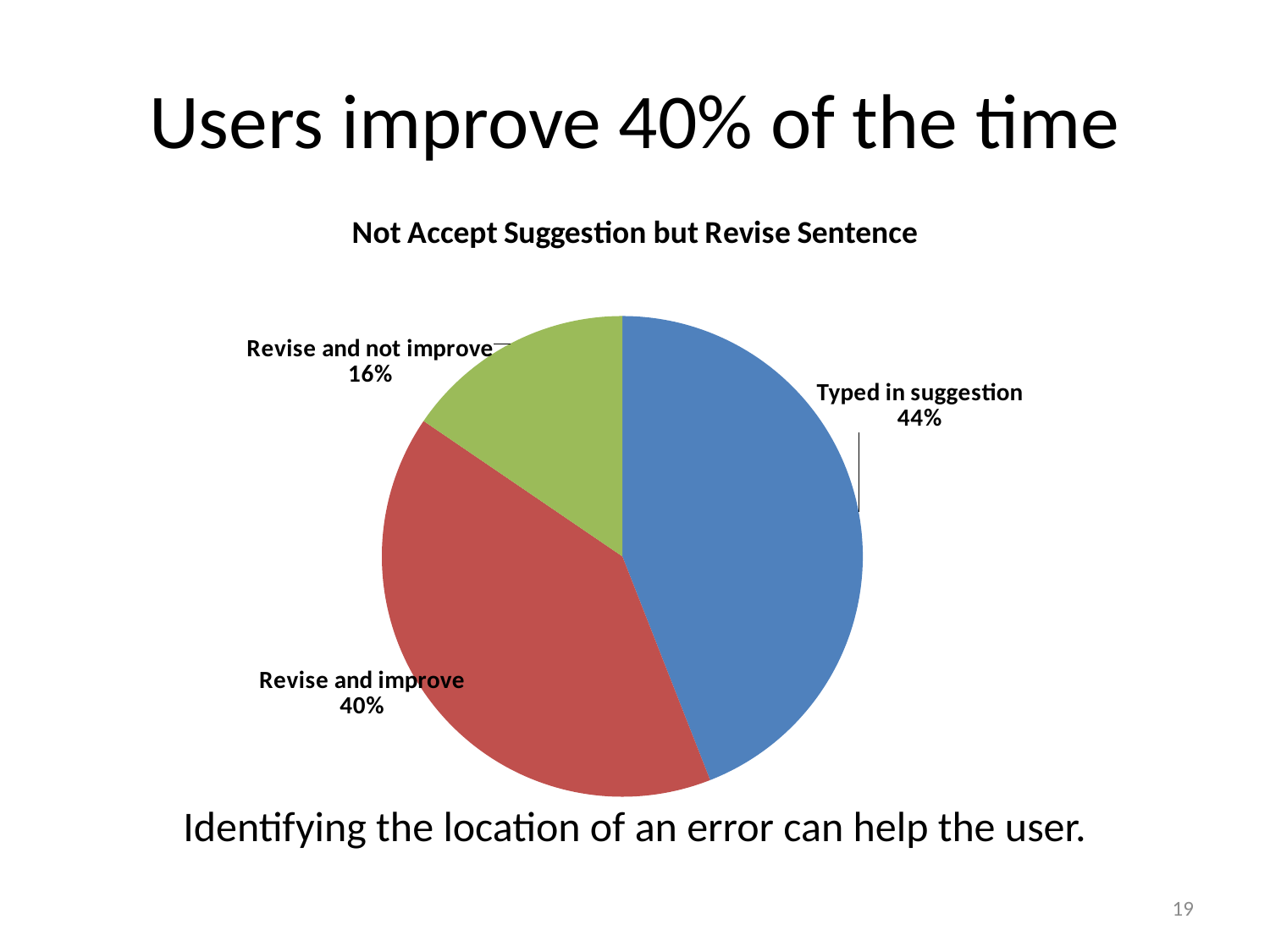
What percentage of the pie is 'Revise and not improve'? 16% What colour is the 'Revise and improve' slice? red What is the title of the chart? Not Accept Suggestion but Revise Sentence What type of chart is shown on the slide? pie chart What is the difference in percentage points between 'Revise and improve' and 'Revise and not improve'? 24 What percentage of the pie is 'Revise and improve'? 40% How many slices does the pie chart have? 3 Which is larger, 'Typed in suggestion' or 'Revise and improve'? Typed in suggestion What is the combined share of 'Revise and improve' and 'Revise and not improve'? 56% Which slice of the pie is the smallest? Revise and not improve What percentage of the pie is 'Typed in suggestion'? 44% Which slice of the pie is the largest? Typed in suggestion